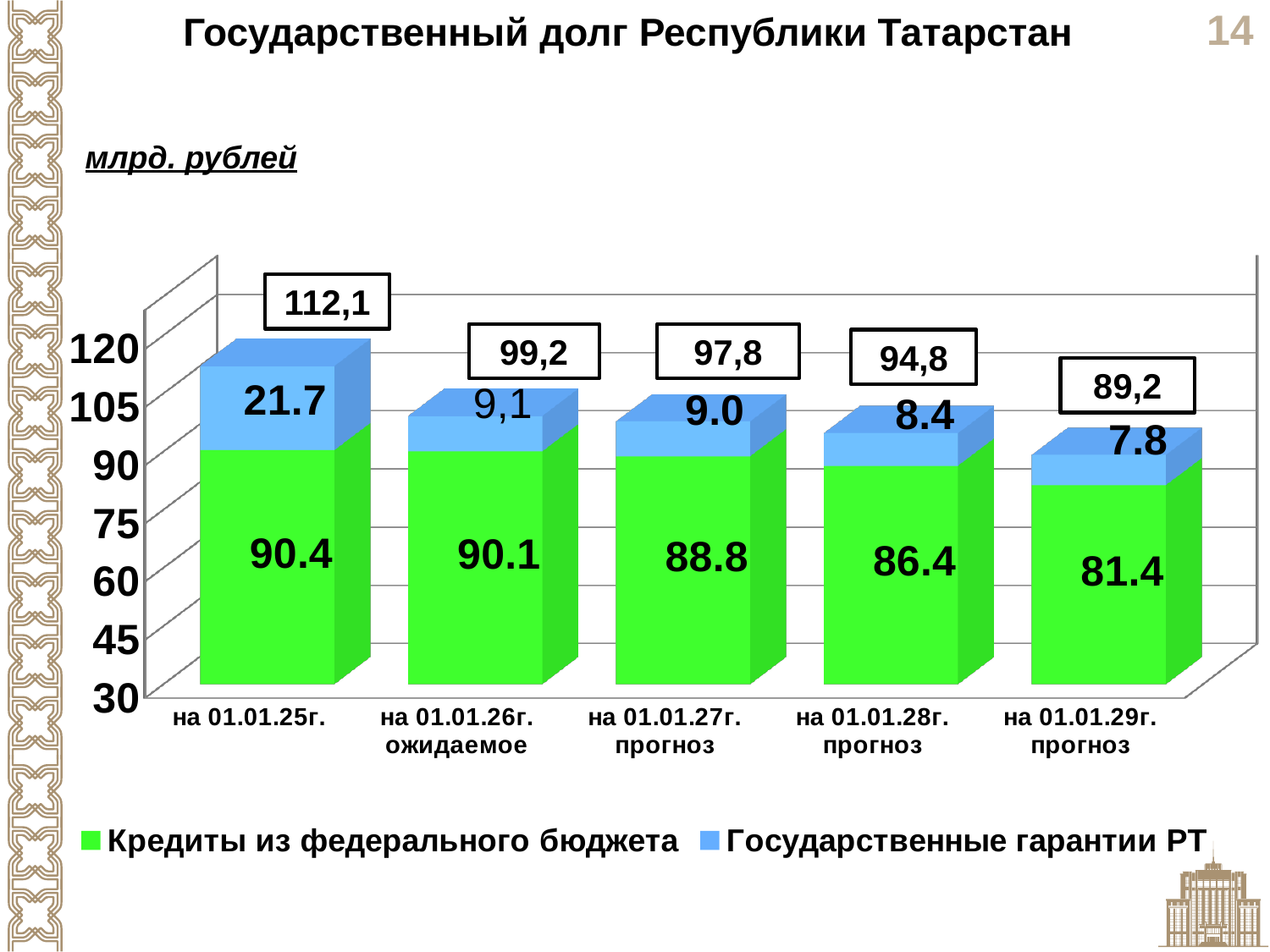
How many categories (dates) are shown on the x axis? 5 What is the total of the stacked bar for "на 01.01.28г. прогноз"? 94,8 What is the difference between the "Кредиты из федерального бюджета" values for "на 01.01.25г." and "на 01.01.29г. прогноз"? 9.0 What is the value of "Кредиты из федерального бюджета" for "на 01.01.25г."? 90.4 How many series does the legend list? 2 What is the value of "Государственные гарантии РТ" for "на 01.01.27г. прогноз"? 9.0 Which category has the highest value for "Государственные гарантии РТ"? на 01.01.25г. What is the total state debt shown above the bar for "на 01.01.26г. ожидаемое"? 99,2 Do the total debt values rise or fall from "на 01.01.25г." to "на 01.01.29г. прогноз"? Fall What kind of chart is shown on the slide? Stacked bar chart Which is larger: "Государственные гарантии РТ" for "на 01.01.28г. прогноз" or for "на 01.01.29г. прогноз"? на 01.01.28г. прогноз Which category has the lowest value for "Кредиты из федерального бюджета"? на 01.01.29г. прогноз